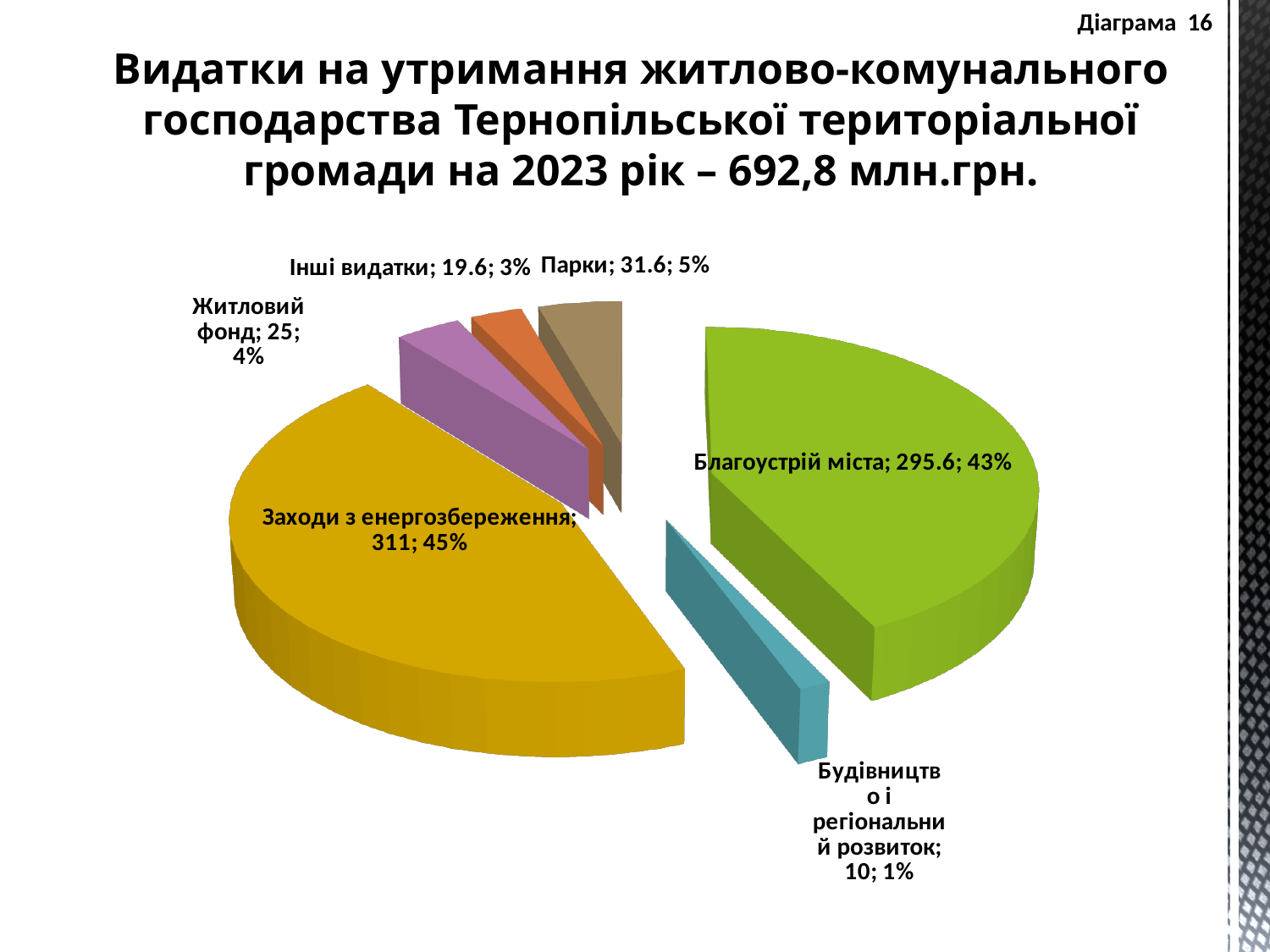
What is the value for Парки? 31.6 What share of the pie does Житловий фонд represent? 4% What share of the pie does Інші видатки represent? 3% How many slices does the pie chart have? 6 What is the value for Будівництво і регіональний розвиток? 10 What is the difference between the values for Заходи з енергозбереження and Благоустрій міста? 15.4 Which category has the smallest slice? Будівництво і регіональний розвиток What is the value for Благоустрій міста? 295.6 Which category has the largest slice? Заходи з енергозбереження What is the value for Заходи з енергозбереження? 311 Which is larger, the value for Парки or the value for Житловий фонд? Парки What type of chart is shown on the slide? pie chart